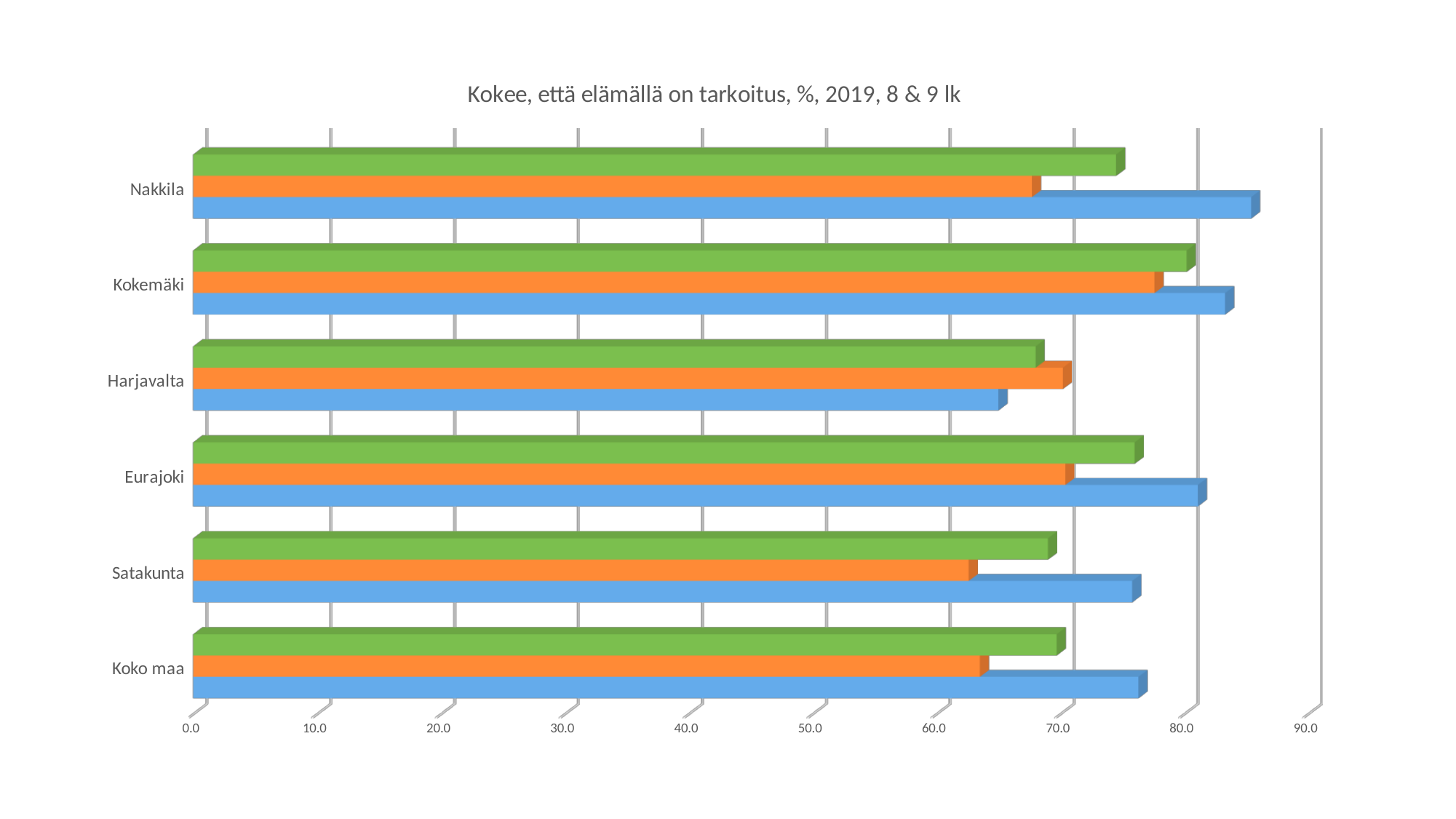
Is the orange bar for Satakunta greater or less than 70.0? less Which category has the longest blue bar? Nakkila Which category has the longest orange bar? Kokemäki How many bars are plotted for each category in the chart? 3 For Harjavalta, which bar is longer, the orange bar or the blue bar? orange What is the title of the chart? Kokee, että elämällä on tarkoitus, %, 2019, 8 & 9 lk Is the blue bar for Nakkila greater or less than 80.0? greater What kind of chart is shown on the slide? bar chart Is the blue bar for Harjavalta greater or less than 70.0? less How many categories are shown on the vertical axis of the chart? 6 Which category has the shortest blue bar? Harjavalta